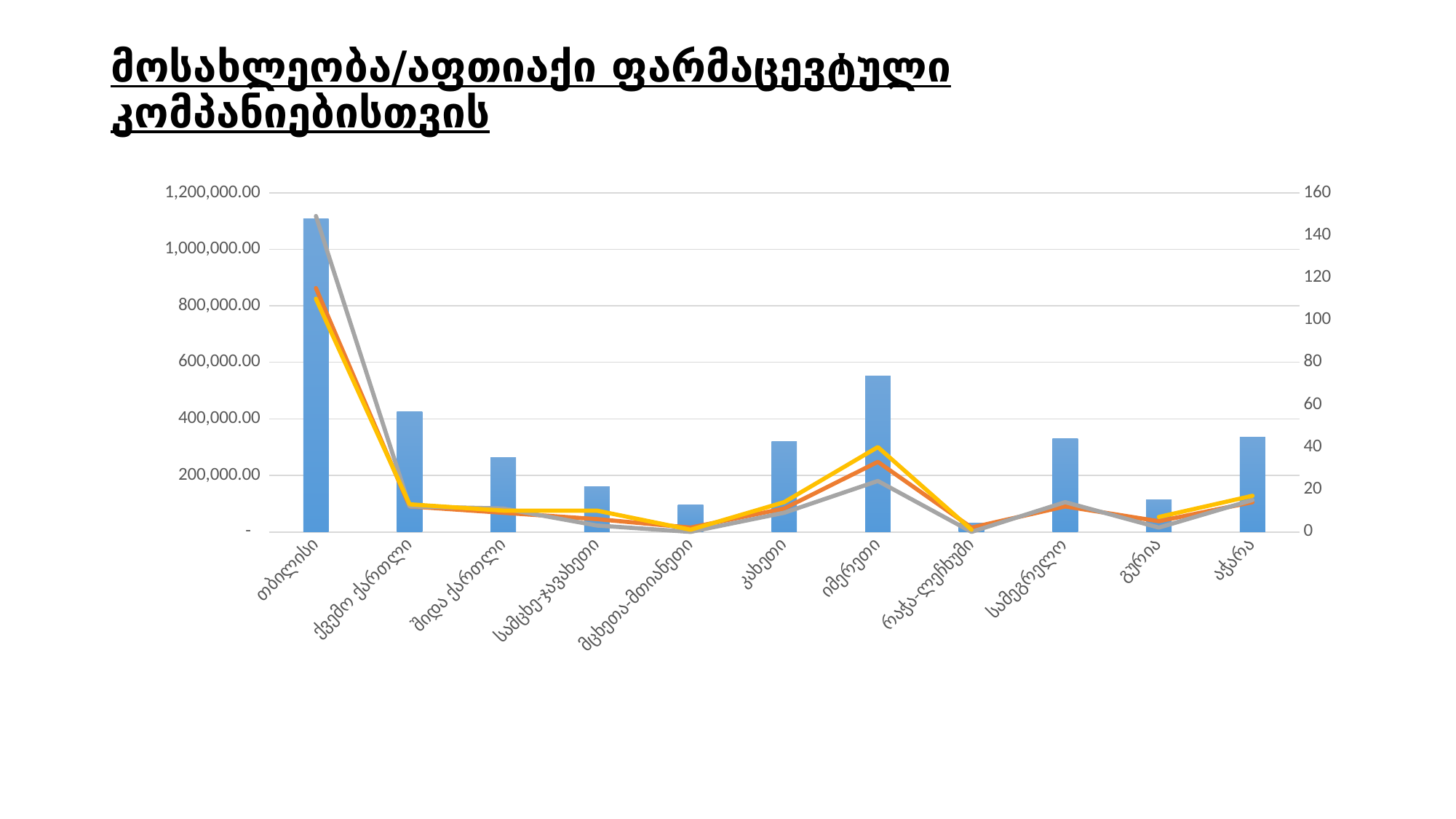
Is the bar value for თბილისი greater or less than 1,000,000.00? greater Which category has the shortest bar? რაჭა-ლეჩხუმი Which has the larger bar, იმერეთი or კახეთი? იმერეთი Which category has the tallest bar? თბილისი How many categories are shown along the x axis? 11 What kind of chart is shown on the slide? A combined bar and line chart Do the line values rise or fall from თბილისი to ქვემო ქართლი? fall Is the bar value for იმერეთი greater or less than 400,000.00? greater How many line series are plotted on the chart? 3 Which has the larger bar, სამეგრელო or გურია? სამეგრელო Is the bar value for აჭარა greater or less than 200,000.00? greater